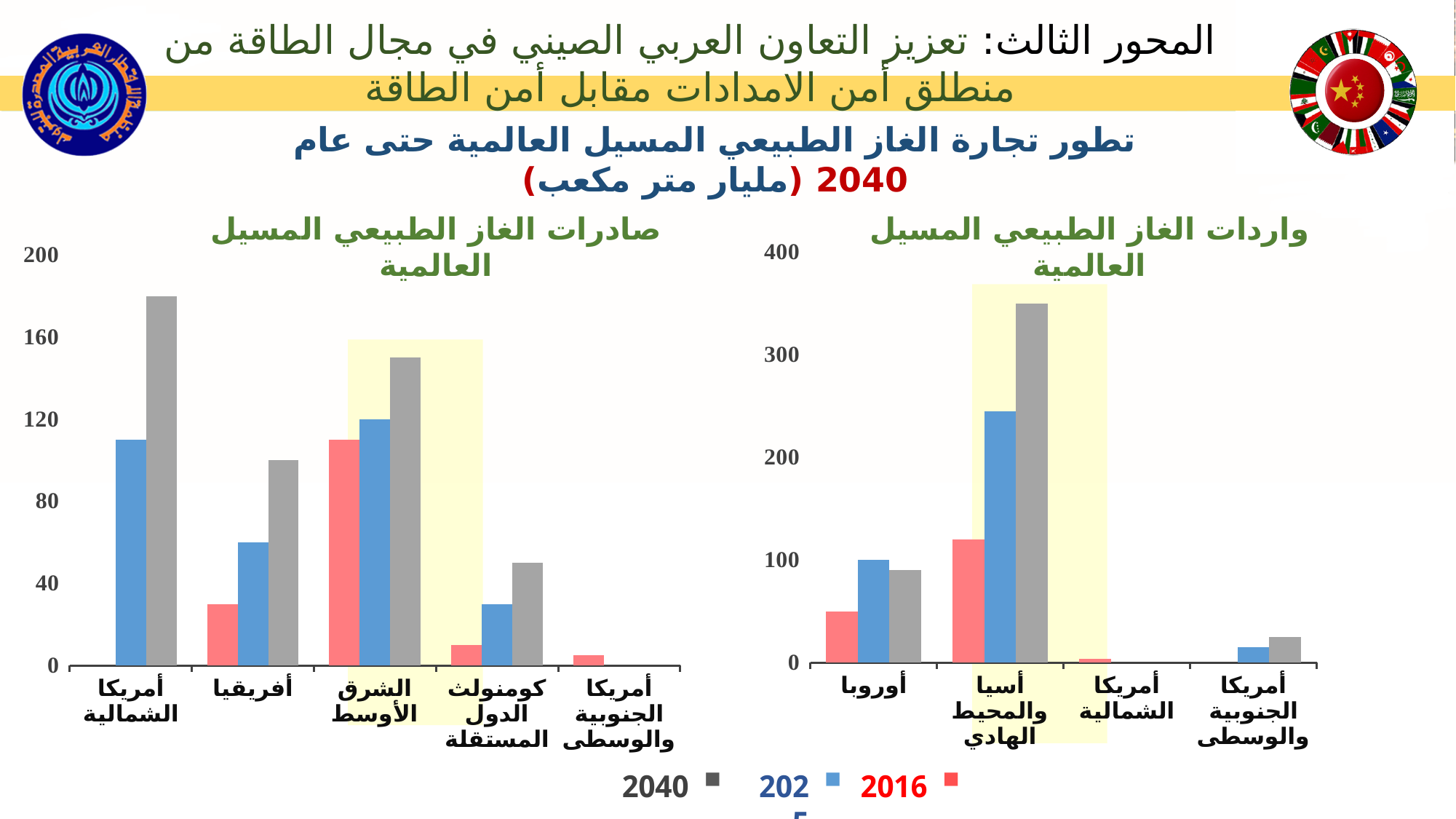
In the left chart (صادرات الغاز الطبيعي المسيل العالمية), how many regions are shown on the x axis? 5 What kind of chart is the left chart titled صادرات الغاز الطبيعي المسيل العالمية? bar chart In the left chart (صادرات الغاز الطبيعي المسيل العالمية), is the 2025 value for أفريقيا greater or less than 80? less In the right chart (واردات الغاز الطبيعي المسيل العالمية), do the values for أسيا والمحيط الهادي rise or fall from 2016 to 2025 to 2040? rise What colour represents the 2016 series in the legend? red How many series does the legend list for the charts? 3 In the right chart (واردات الغاز الطبيعي المسيل العالمية), how many regions are shown on the x axis? 4 In the left chart (صادرات الغاز الطبيعي المسيل العالمية), is the 2040 value for أمريكا الشمالية greater or less than 160? greater In the left chart (صادرات الغاز الطبيعي المسيل العالمية), which region has the highest 2040 value? أمريكا الشمالية In the right chart (واردات الغاز الطبيعي المسيل العالمية), is the 2040 value for أسيا والمحيط الهادي greater or less than 300? greater In the right chart (واردات الغاز الطبيعي المسيل العالمية), which region has the highest 2040 value? أسيا والمحيط الهادي In the left chart (صادرات الغاز الطبيعي المسيل العالمية), which has the larger 2040 value: أفريقيا or الشرق الأوسط? الشرق الأوسط